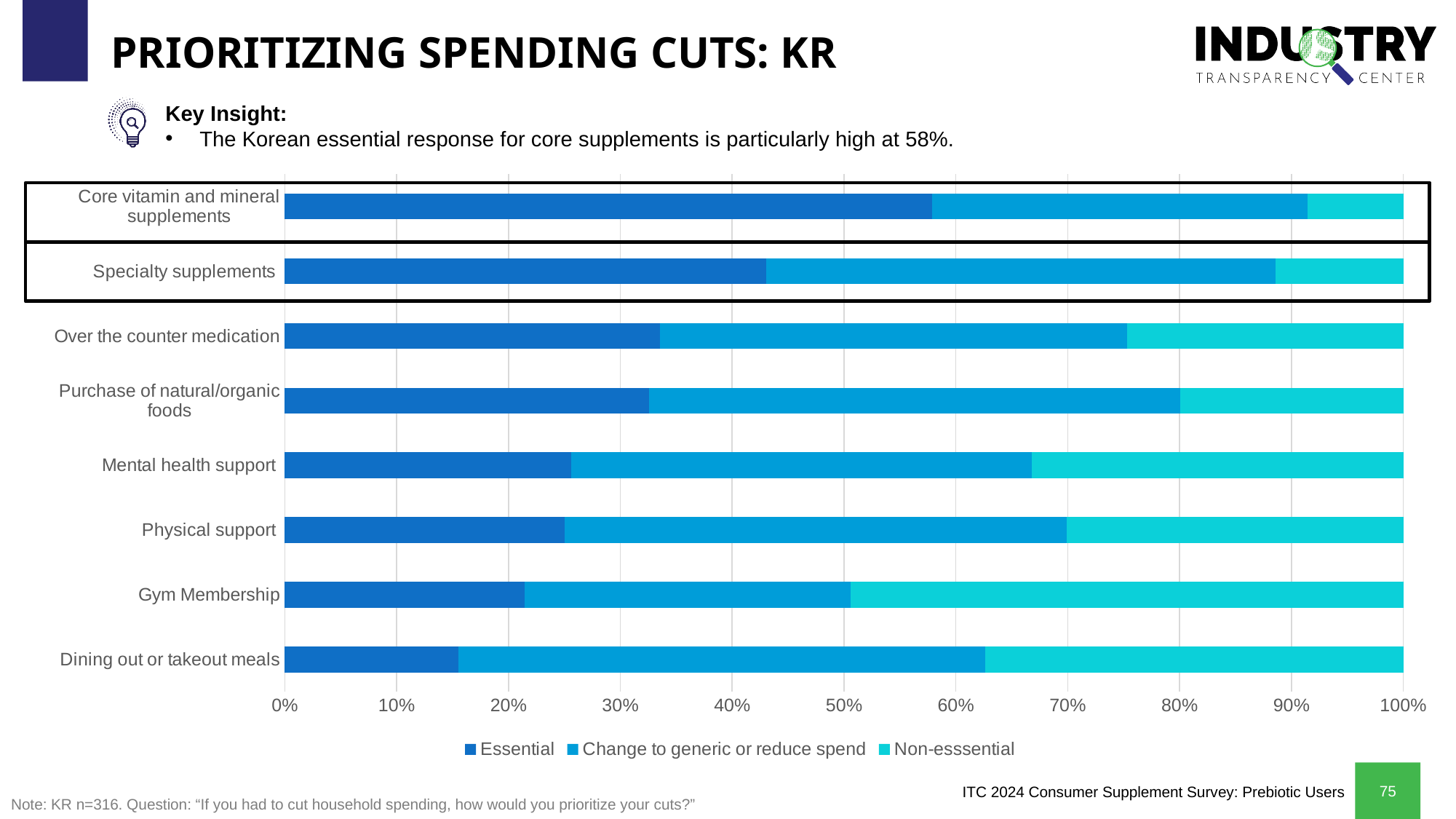
What kind of chart is shown on the slide? bar chart Which category has the smallest Essential share? Dining out or takeout meals Is the Essential share for Gym Membership greater or less than 30%? less Is the Essential share for Specialty supplements greater or less than 40%? greater Which category has the largest Non-esssential segment? Gym Membership What is the Essential share for Core vitamin and mineral supplements? 58% How many series does the chart legend list? 3 Which has a larger Essential share: Over the counter medication or Mental health support? Over the counter medication Is the Essential share for Dining out or takeout meals greater or less than 20%? less Which category has the largest Essential share? Core vitamin and mineral supplements How many spending categories are listed on the chart? 8 Going from the top category to the bottom category, do the Essential segments get larger or smaller? smaller